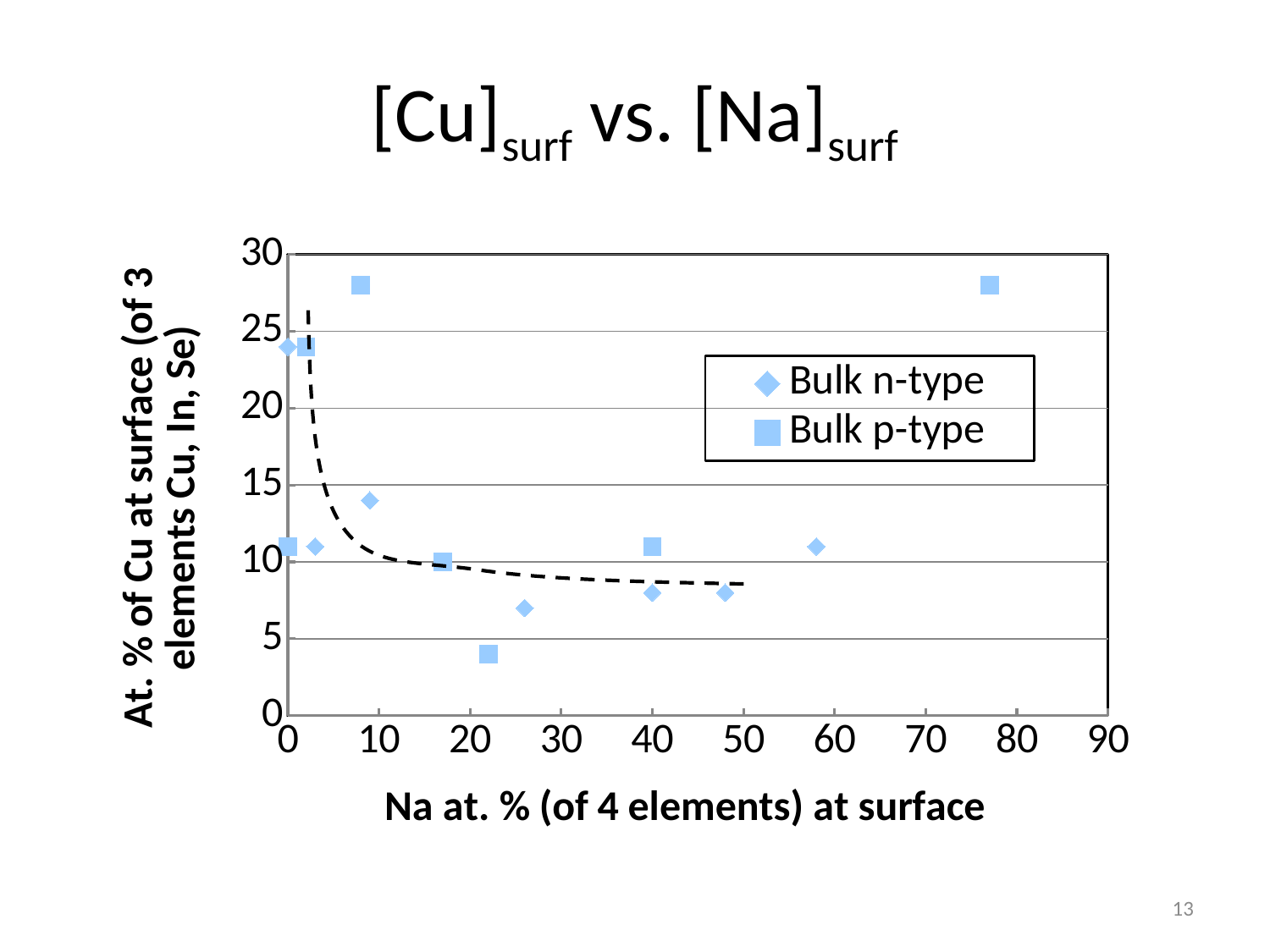
Does the dashed trend line rise or fall as Na at. % increases? fall What kind of chart is shown on the slide? scatter chart How many series does the legend list? 2 What is the title of the x axis? Na at. % (of 4 elements) at surface What are the two series named in the legend? Bulk n-type and Bulk p-type Which series has the point with the highest Cu value, Bulk n-type or Bulk p-type? Bulk p-type How many Bulk p-type (square) points are plotted? 7 Is the Cu value for the Bulk p-type point near Na 22 greater or less than 5? less How many Bulk n-type (diamond) points are plotted? 7 Is the Cu value for the Bulk p-type point near Na 77 greater or less than 25? greater Is the Cu value for the Bulk n-type point at Na 0 greater or less than 20? greater